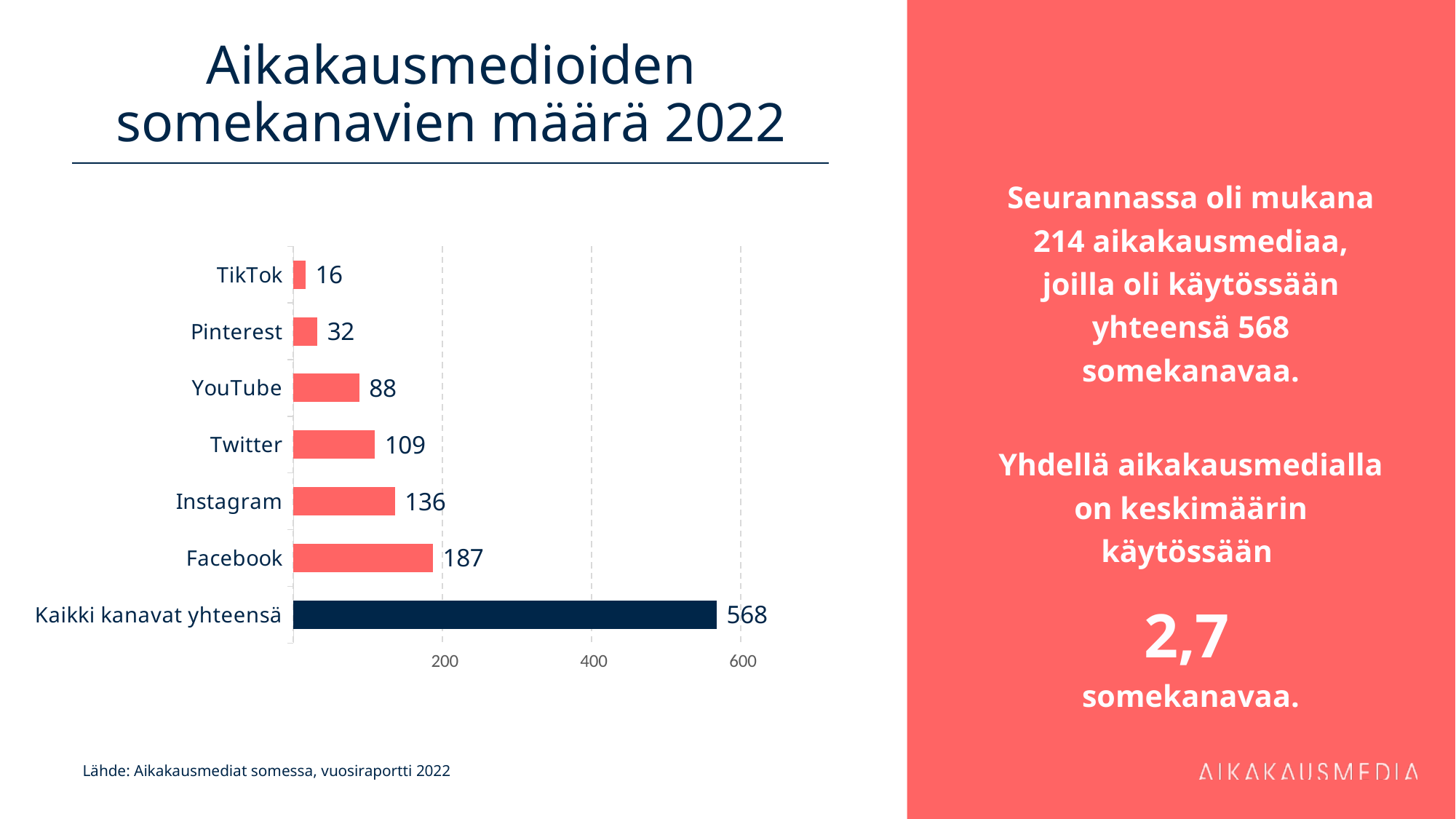
What is the value for Kaikki kanavat yhteensä? 568 Which category has the lowest value? TikTok What is the difference between the values for Twitter and YouTube? 21 What kind of chart is shown on the slide? Bar chart What is the value for TikTok? 16 Which individual channel has the highest value? Facebook What is the title of the slide? Aikakausmedioiden somekanavien määrä 2022 How many categories are shown in the chart? 7 Which is larger, the value for Pinterest or the value for YouTube? YouTube What is the value for Facebook? 187 What is the difference between the values for Facebook and Instagram? 51 What is the value for Instagram? 136